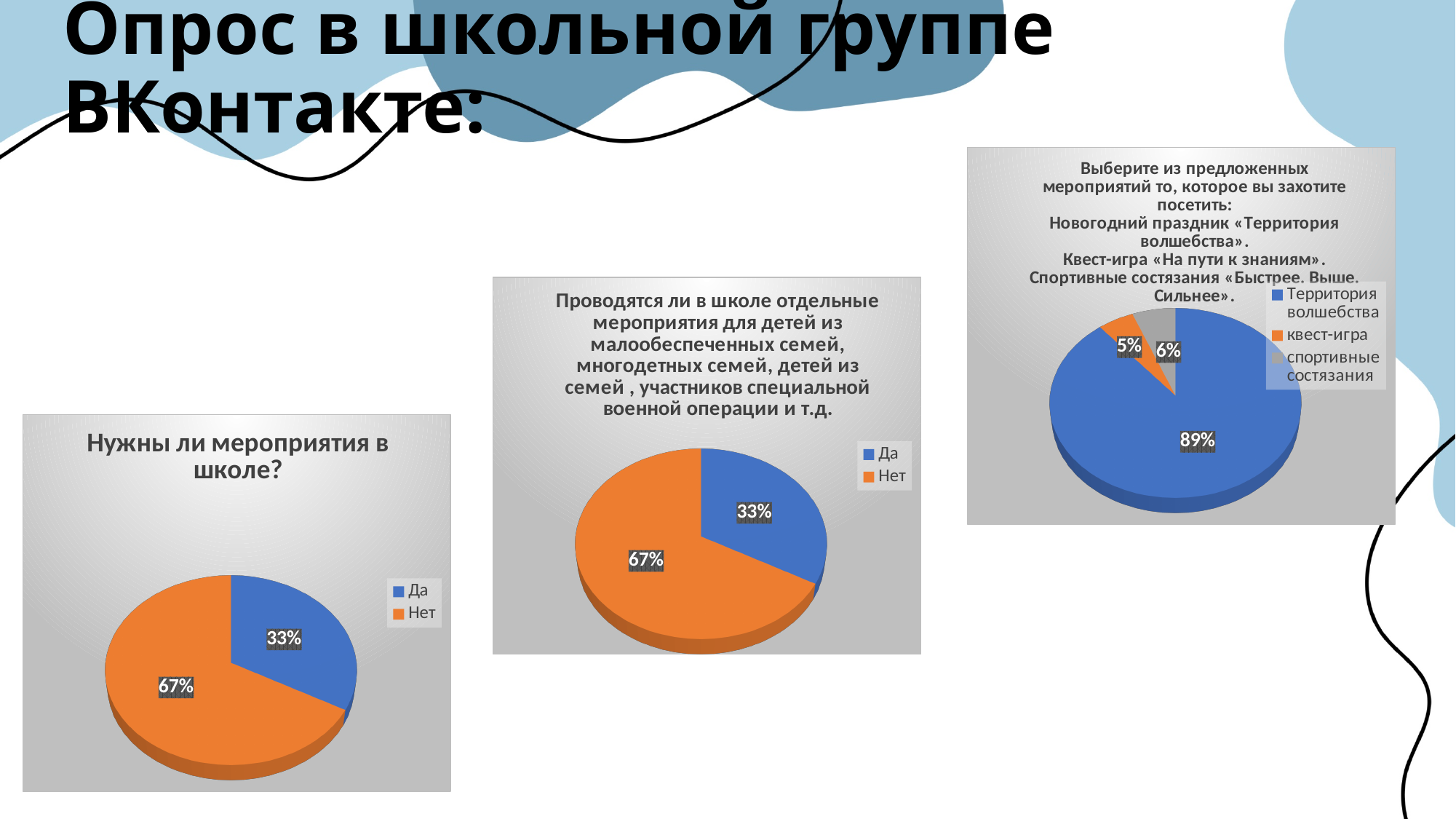
In the left chart titled "Нужны ли мероприятия в школе?", which answer has the larger share? Нет In the right chart asking which event respondents would like to attend, what share chose "квест-игра"? 5% In the left chart titled "Нужны ли мероприятия в школе?", what share of respondents answered "Да"? 33% In the middle chart, what share of respondents answered "Да"? 33% How many entries does the legend of the middle chart list? 2 In the left chart titled "Нужны ли мероприятия в школе?", what is the difference between the "Нет" and "Да" shares? 34% In the right chart asking which event respondents would like to attend, which option has the smallest share? квест-игра In the middle chart, what share of respondents answered "Нет"? 67% In the right chart asking which event respondents would like to attend, what share chose "Территория волшебства"? 89% In the left chart titled "Нужны ли мероприятия в школе?", what share of respondents answered "Нет"? 67% How many slices does the right chart asking which event respondents would like to attend have? 3 What kind of chart is the middle chart about whether the school holds separate events for children from low-income families? Pie chart